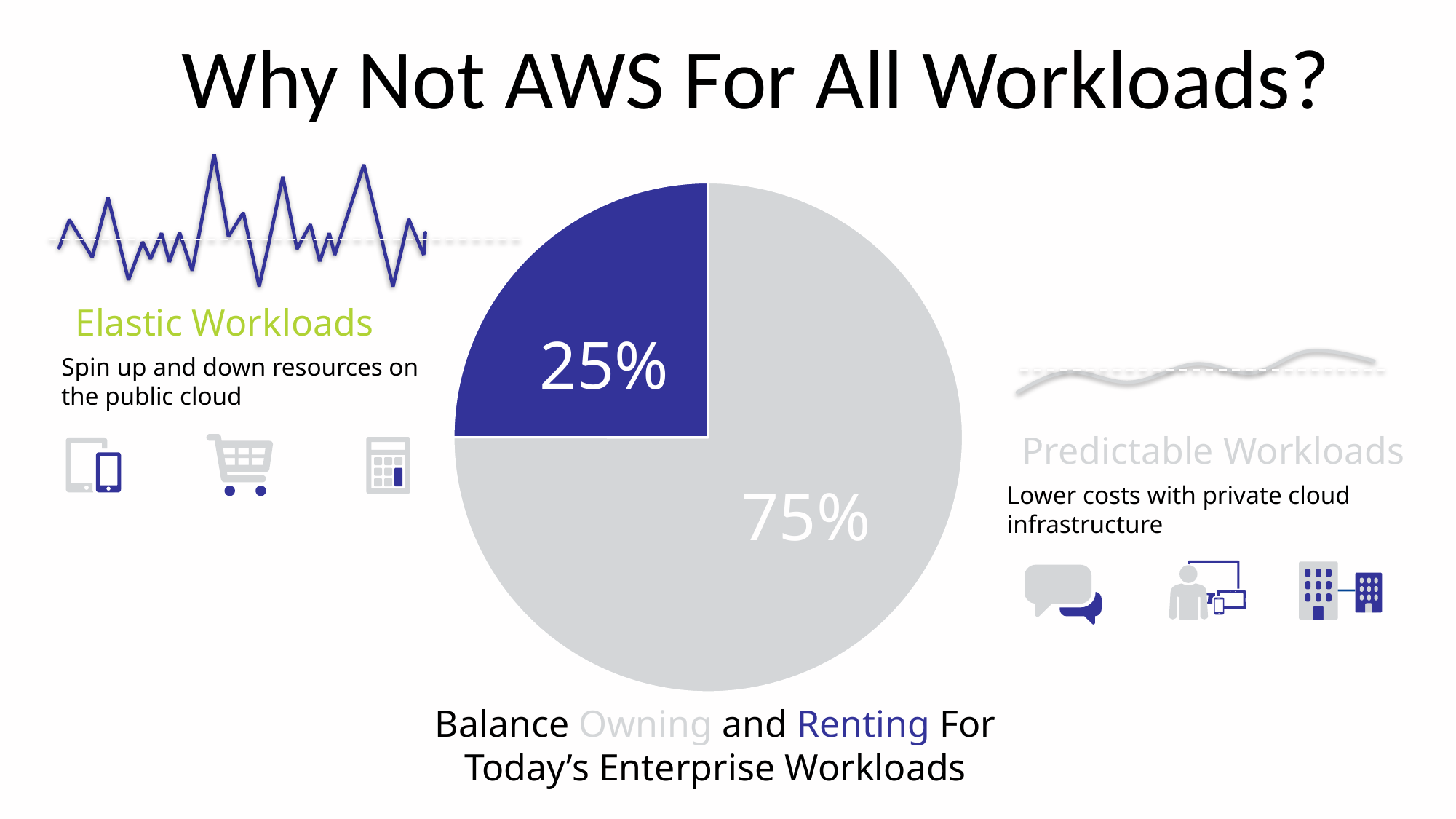
Which is larger in the pie chart, the blue slice or the grey slice? the grey slice What is the total of the two slices shown in the pie chart? 100% How many slices does the pie chart have? 2 Which slice of the pie chart is the largest? the grey slice (75%) What percentage is shown on the blue slice of the pie chart? 25% What percentage is shown on the grey slice of the pie chart? 75% What is the title of the slide containing the pie chart? Why Not AWS For All Workloads? Is the blue slice of the pie chart greater or less than 50%? less What kind of chart is shown in the centre of the slide? pie chart What share of the pie does the grey slice represent? 75% Which slice of the pie chart is the smallest? the blue slice (25%) What is the difference in percentage points between the grey slice and the blue slice of the pie chart? 50